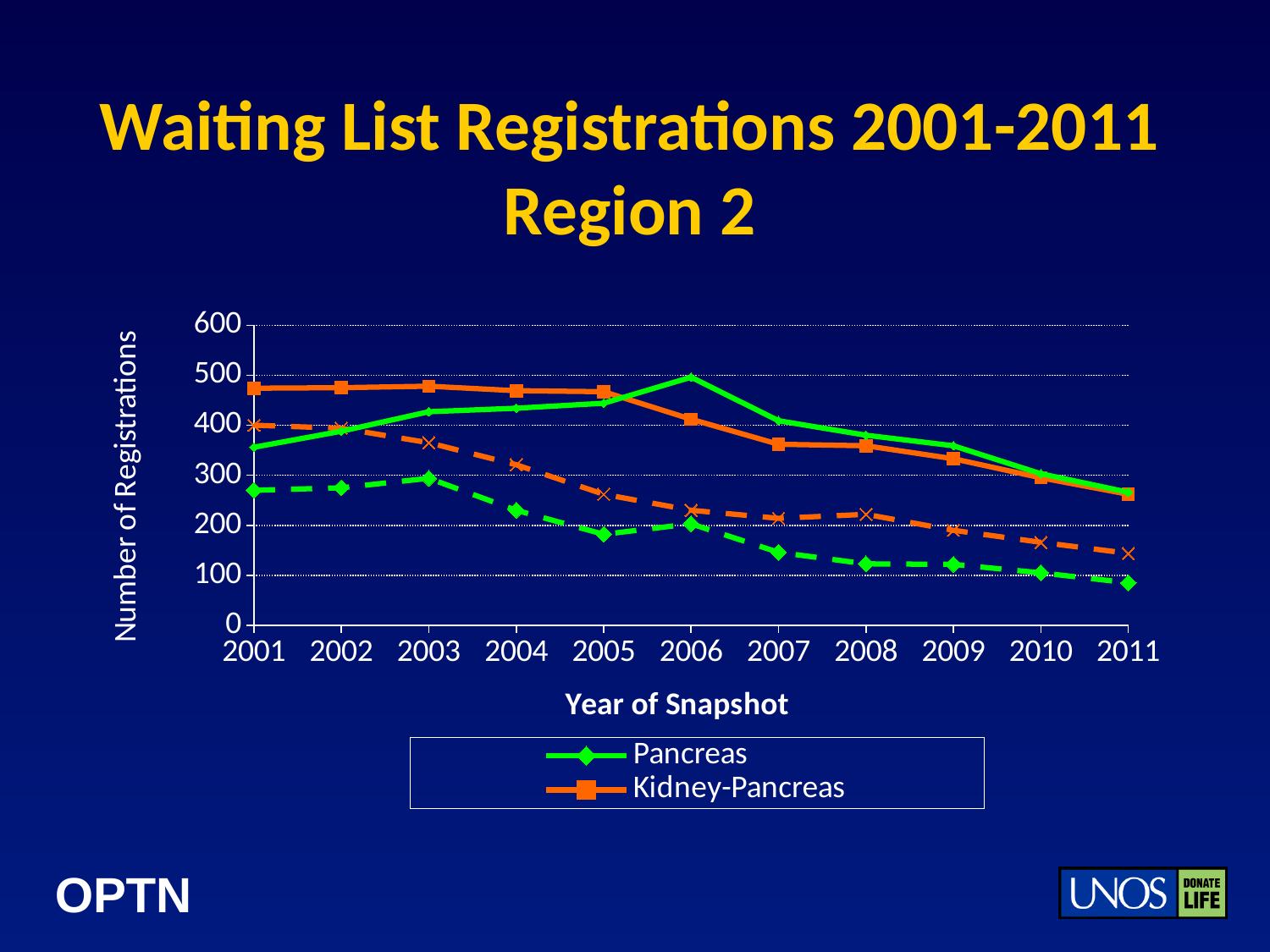
Is the value of the solid Kidney-Pancreas line in 2011 greater or less than 300? less In 2006, which solid line is higher: Pancreas or Kidney-Pancreas? Pancreas Is the value of the solid Pancreas line in 2006 greater or less than 400? greater Does the solid Kidney-Pancreas line rise or fall from 2006 to 2011? fall How many years are shown along the x axis? 11 In 2001, which solid line is higher: Pancreas or Kidney-Pancreas? Kidney-Pancreas How many series does the legend list? 2 In which year does the solid Pancreas line reach its highest value? 2006 What is the title of the x axis? Year of Snapshot Is the value of the solid Pancreas line in 2001 greater or less than 400? less What kind of chart is shown on the slide? line chart